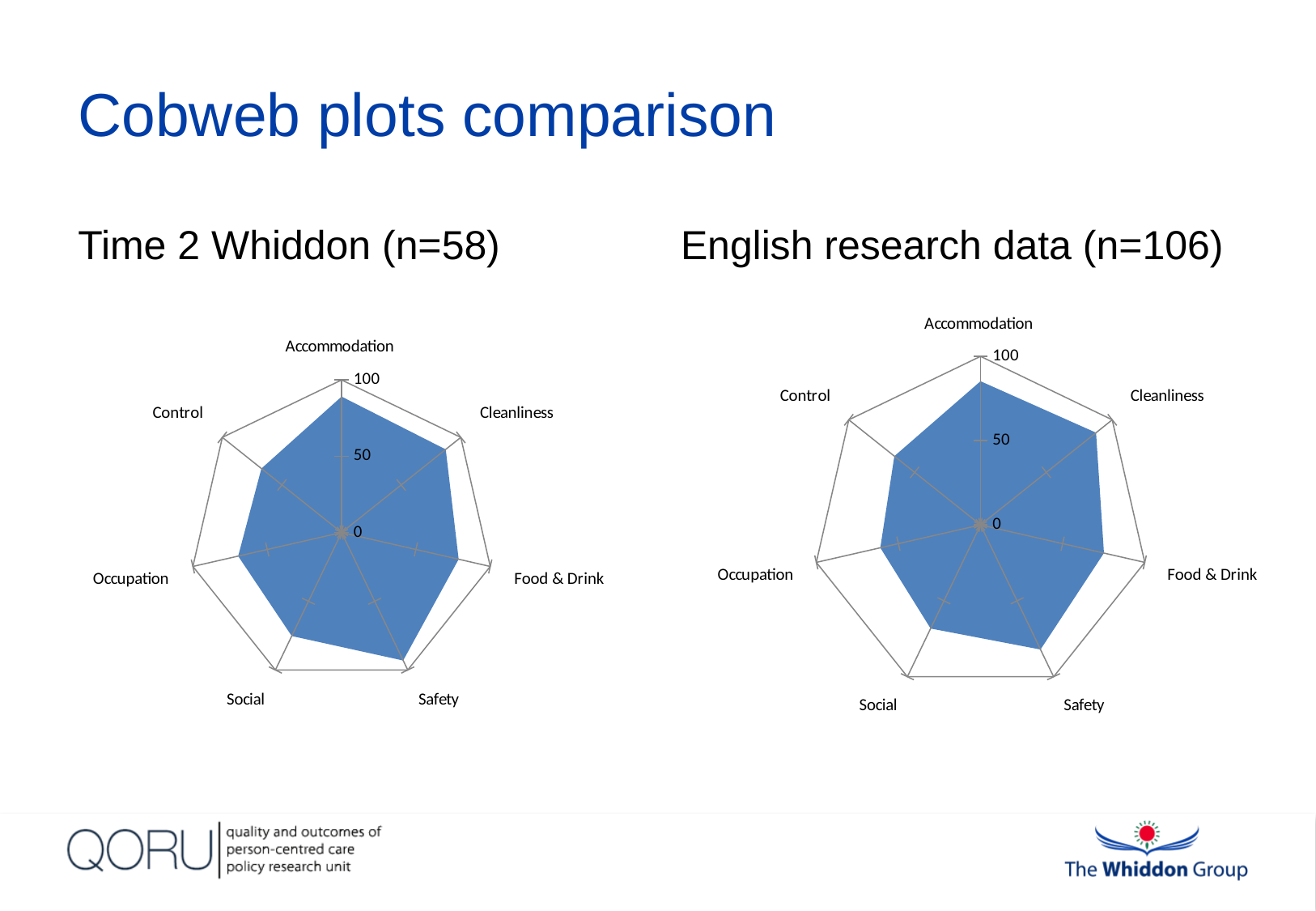
In the 'Time 2 Whiddon (n=58)' chart, which is larger, the value for Safety or the value for Control? Safety In the 'Time 2 Whiddon (n=58)' chart, is the value for Occupation greater or less than 50? greater In the 'Time 2 Whiddon (n=58)' chart, which category has the highest value? Safety What is the maximum value shown on the axis of the 'English research data (n=106)' chart? 100 What kind of chart is the 'Time 2 Whiddon (n=58)' chart? radar chart In the 'English research data (n=106)' chart, which is larger, the value for Food & Drink or the value for Occupation? Food & Drink In the 'Time 2 Whiddon (n=58)' chart, is the value for Control greater or less than 50? greater In the 'English research data (n=106)' chart, is the value for Food & Drink greater or less than 50? greater How many categories are plotted on the 'Time 2 Whiddon (n=58)' chart? 7 What is the title of the chart on the left of the slide? Time 2 Whiddon (n=58) How many categories are plotted on the 'English research data (n=106)' chart? 7